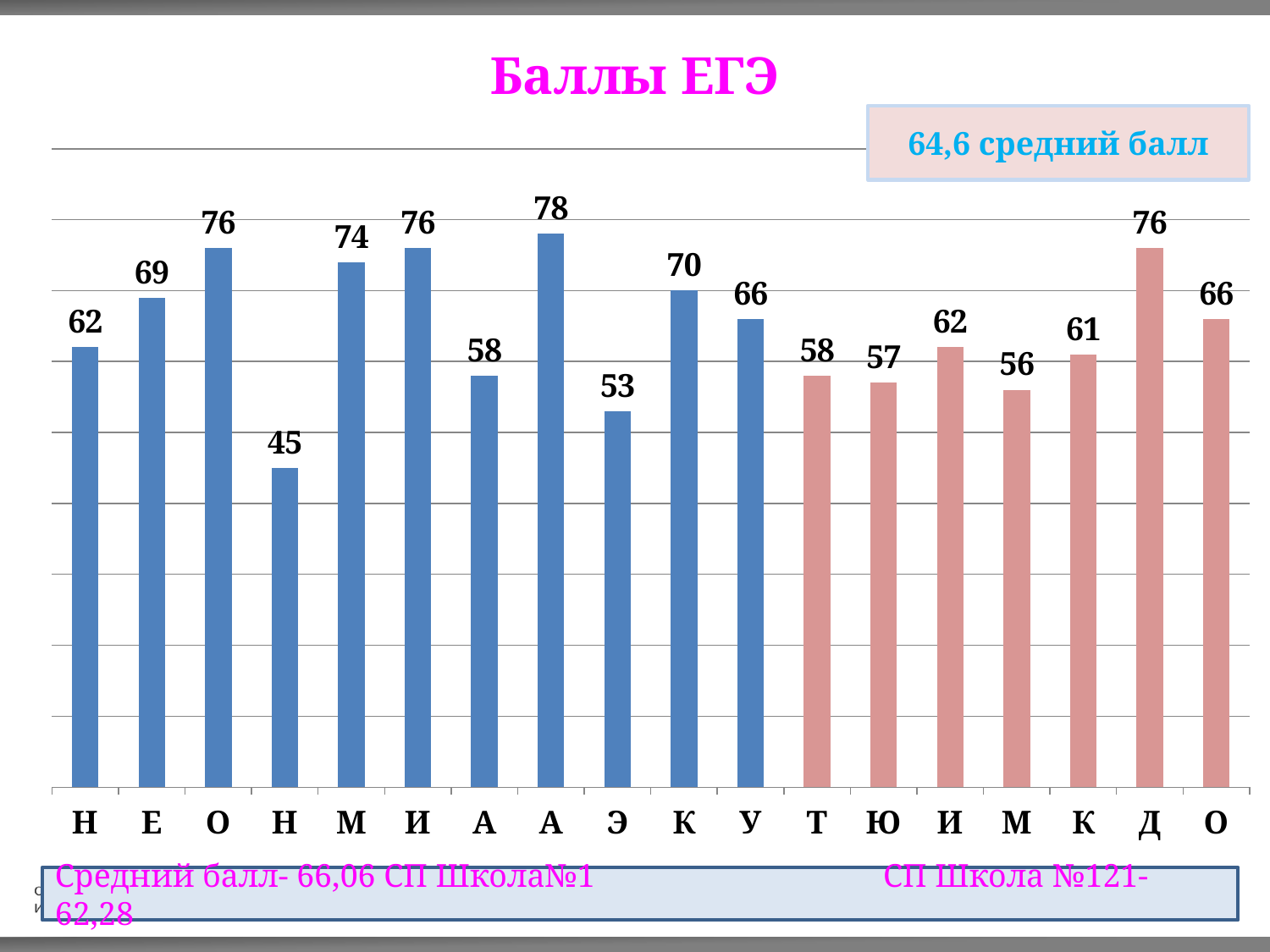
What is the highest value shown in the chart? 78 What average score is shown in the box at the top right of the chart? 64,6 средний балл What is the value for the bar labelled Д? 76 How many bars are plotted in the chart? 18 What is the value for the bar labelled Э? 53 What is the value for the bar labelled Ю? 57 What is the title of the chart? Баллы ЕГЭ What kind of chart is shown on the slide? bar chart What is the lowest value shown in the chart? 45 What is the value for the bar labelled Е? 69 Which has the larger value, the bar labelled Е or the bar labelled Ю? Е What is the difference between the values for the bars labelled У and Т? 8